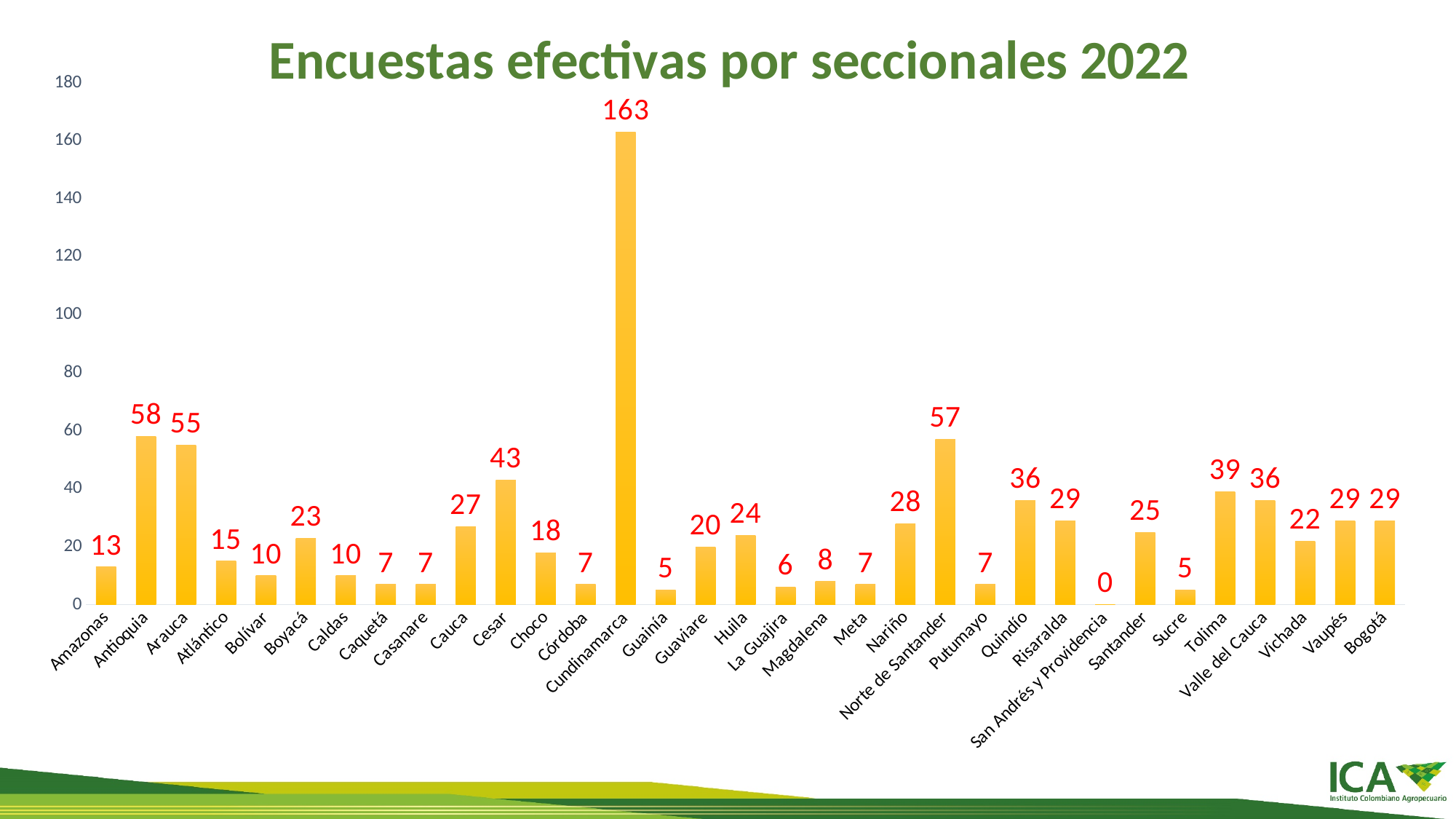
What is the value for Tolima? 39 Which seccional has the lowest value? San Andrés y Providencia How many seccionales are shown on the x axis? 33 What is the value for Cundinamarca? 163 Which seccional has the highest value? Cundinamarca What is the difference between the values for Cundinamarca and Norte de Santander? 106 What kind of chart is shown on the slide? Bar chart What is the value for Norte de Santander? 57 Which is larger, the value for Cesar or the value for Quindío? Cesar What is the difference between the values for Antioquia and Arauca? 3 What is the title of the chart? Encuestas efectivas por seccionales 2022 Is the value for Cundinamarca greater or less than 140? greater